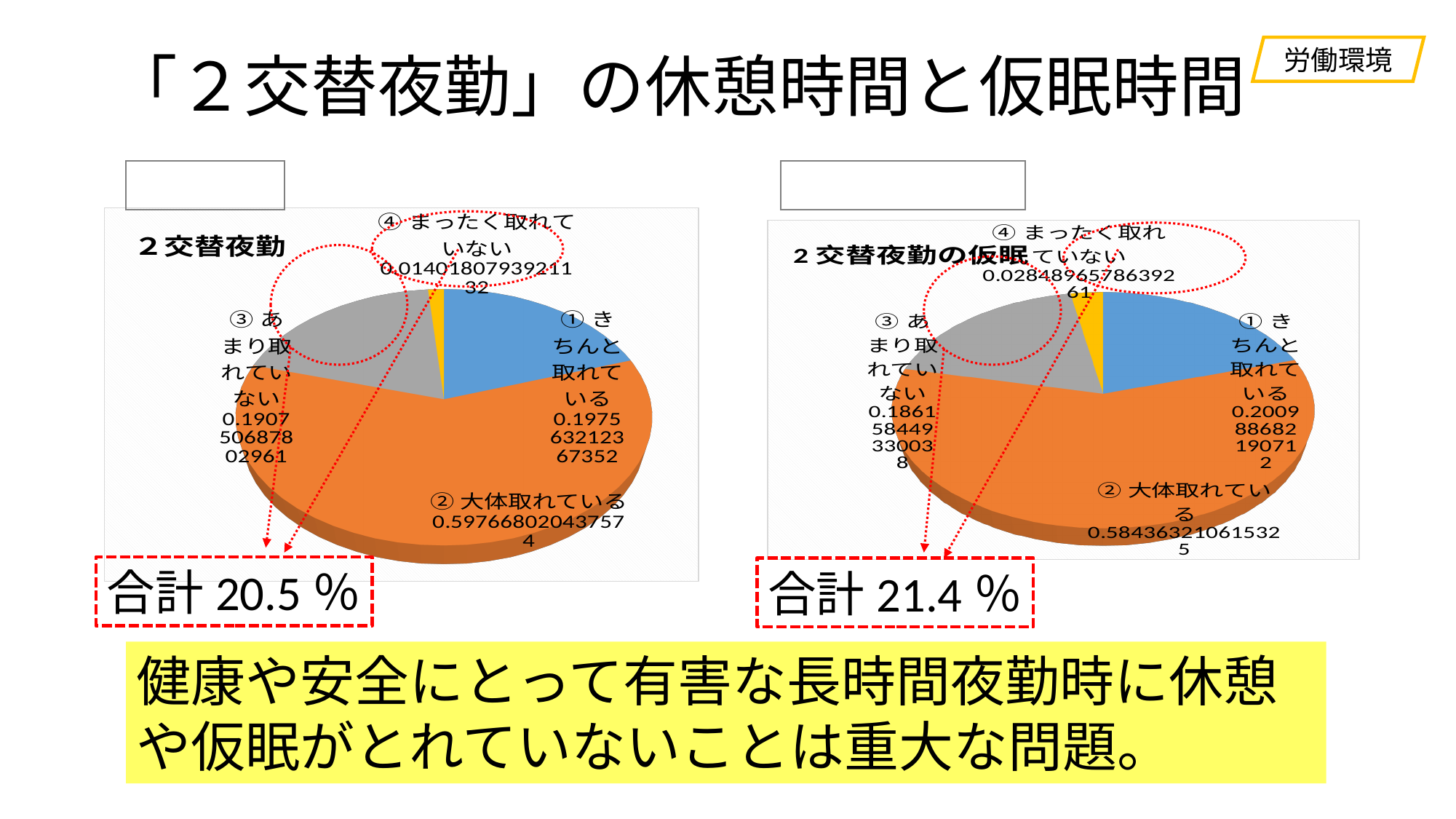
In the left chart titled 「２交替夜勤」, what value is shown for ② 大体取れている? 0.597668020437574 What kind of chart is the left chart titled 「２交替夜勤」? Pie chart What total percentage is written in the red dashed box below the right chart titled 「２交替夜勤の仮眠」? 合計 21.4％ In the right chart titled 「２交替夜勤の仮眠」, what value is shown for ② 大体取れている? 0.584363210615325 In the left chart titled 「２交替夜勤」, which category has the smallest share? ④ まったく取れていない In the right chart titled 「２交替夜勤の仮眠」, which category has the smallest share? ④ まったく取れていない In the left chart titled 「２交替夜勤」, which category has the largest share? ② 大体取れている In the left chart titled 「２交替夜勤」, which is larger: ① きちんと取れている or ③ あまり取れていない? ① きちんと取れている In the right chart titled 「２交替夜勤の仮眠」, which is larger: ① きちんと取れている or ③ あまり取れていない? ① きちんと取れている How many categories (slices) does the right chart titled 「２交替夜勤の仮眠」 have? 4 What total percentage is written in the red dashed box below the left chart titled 「２交替夜勤」? 合計 20.5％ In the right chart titled 「２交替夜勤の仮眠」, which category has the largest share? ② 大体取れている